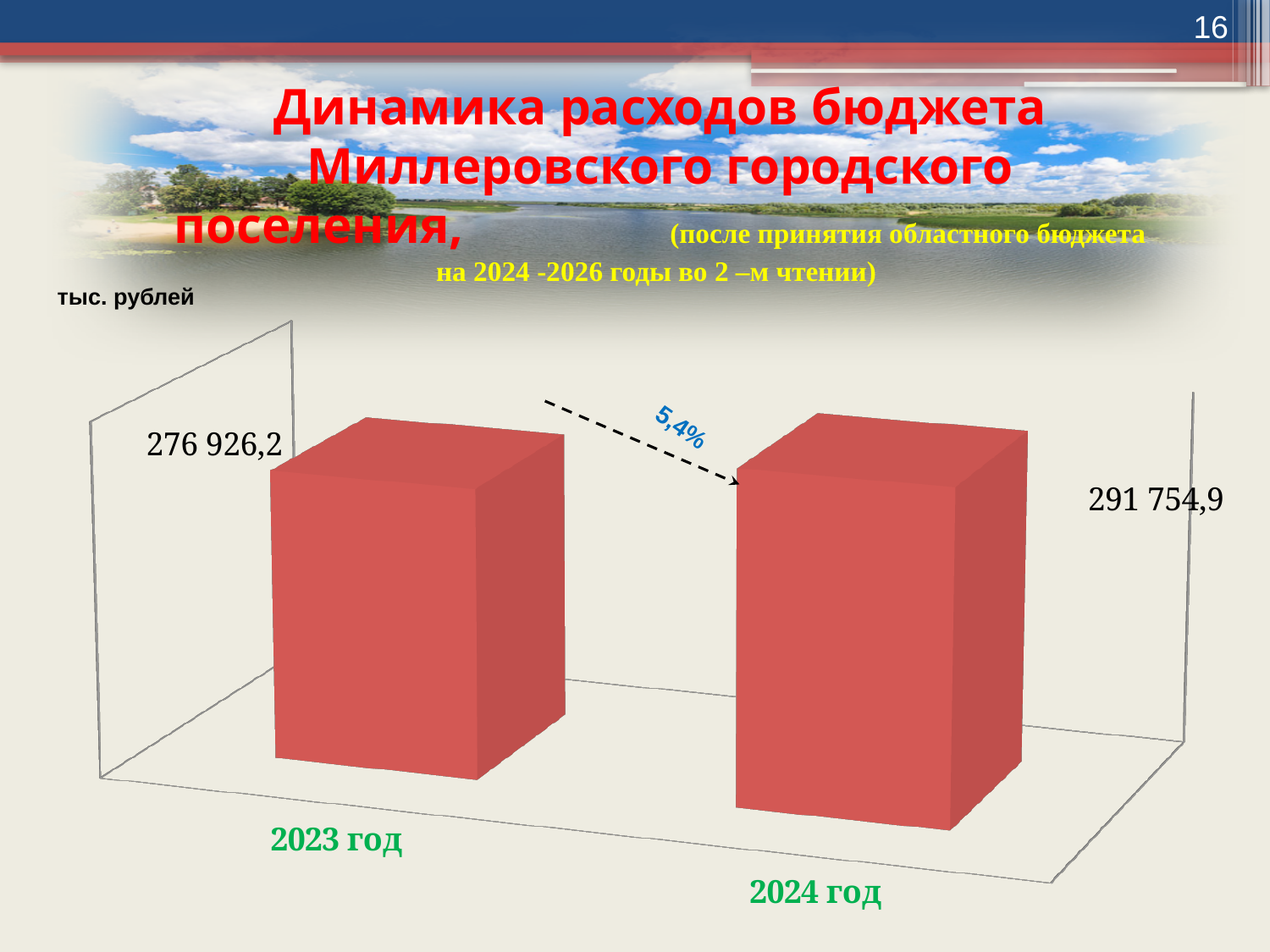
What is the difference between the values for 2024 год and 2023 год? 14 828,7 What colour are the bars in the chart? red What is the value for 2023 год? 276 926,2 What is the value for 2024 год? 291 754,9 In what units are the chart values given? тыс. рублей Which year has the lower value? 2023 год Which year has the higher value? 2024 год Is the value for 2024 год larger or smaller than the value for 2023 год? larger What percentage change is shown by the arrow between the two bars? 5,4% What kind of chart is shown on the slide? bar chart How many bars are shown in the chart? 2 Do the values rise or fall from 2023 год to 2024 год? rise